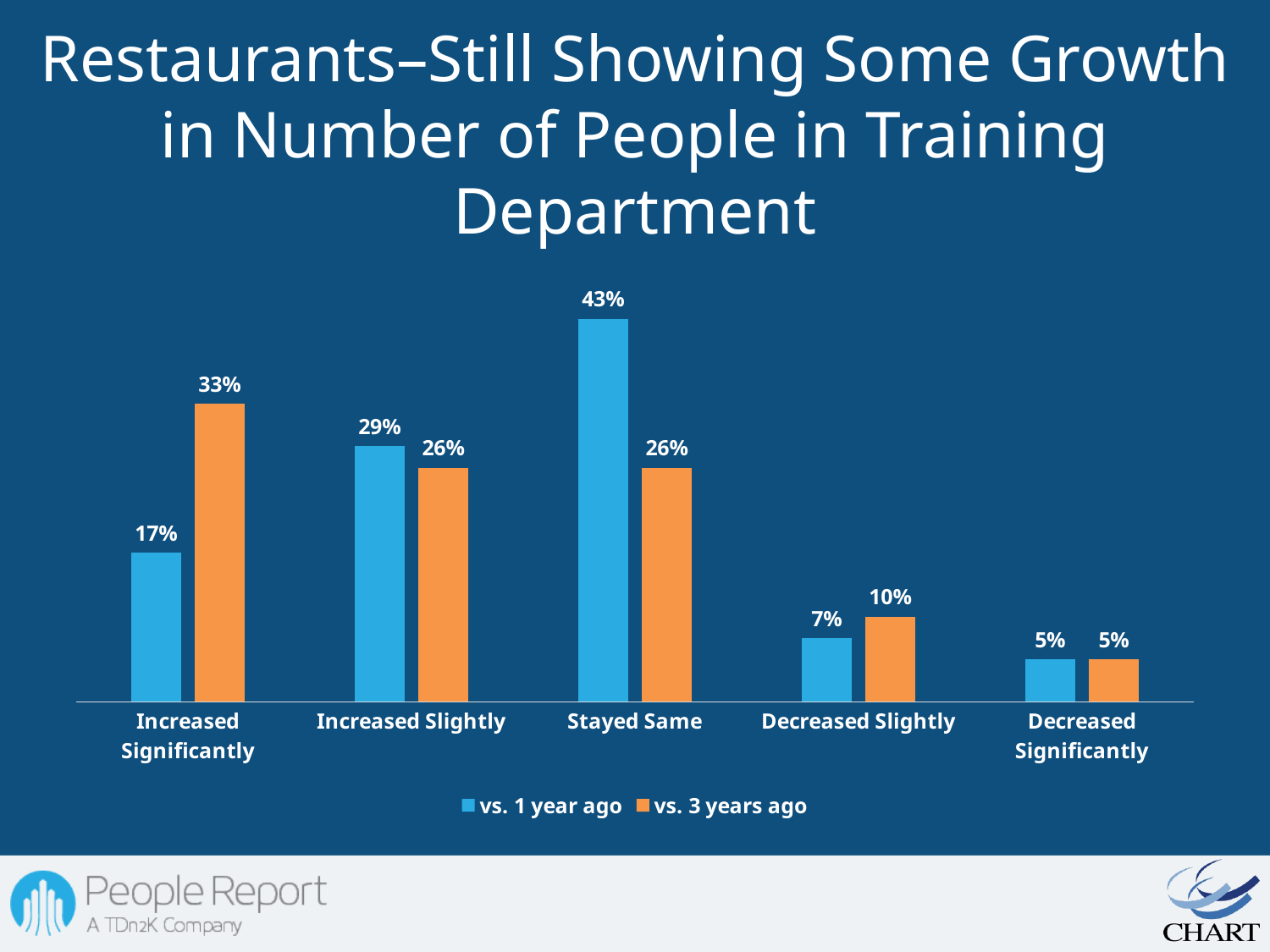
For "Increased Slightly", which series has the larger value: "vs. 1 year ago" or "vs. 3 years ago"? vs. 1 year ago What kind of chart is shown on the slide? Bar chart What is the difference between the "vs. 1 year ago" and "vs. 3 years ago" values for "Stayed Same"? 17% What is the value for "Increased Significantly" in the "vs. 3 years ago" series? 33% Which colour represents the "vs. 3 years ago" series? Orange What is the difference between the "vs. 3 years ago" and "vs. 1 year ago" values for "Increased Significantly"? 16% Which category has the highest value in the "vs. 1 year ago" series? Stayed Same How many series does the legend list? 2 Which category has the lowest value in the "vs. 3 years ago" series? Decreased Significantly What is the value for "Decreased Slightly" in the "vs. 1 year ago" series? 7% What is the value for "Stayed Same" in the "vs. 1 year ago" series? 43% How many categories are shown on the x axis? 5